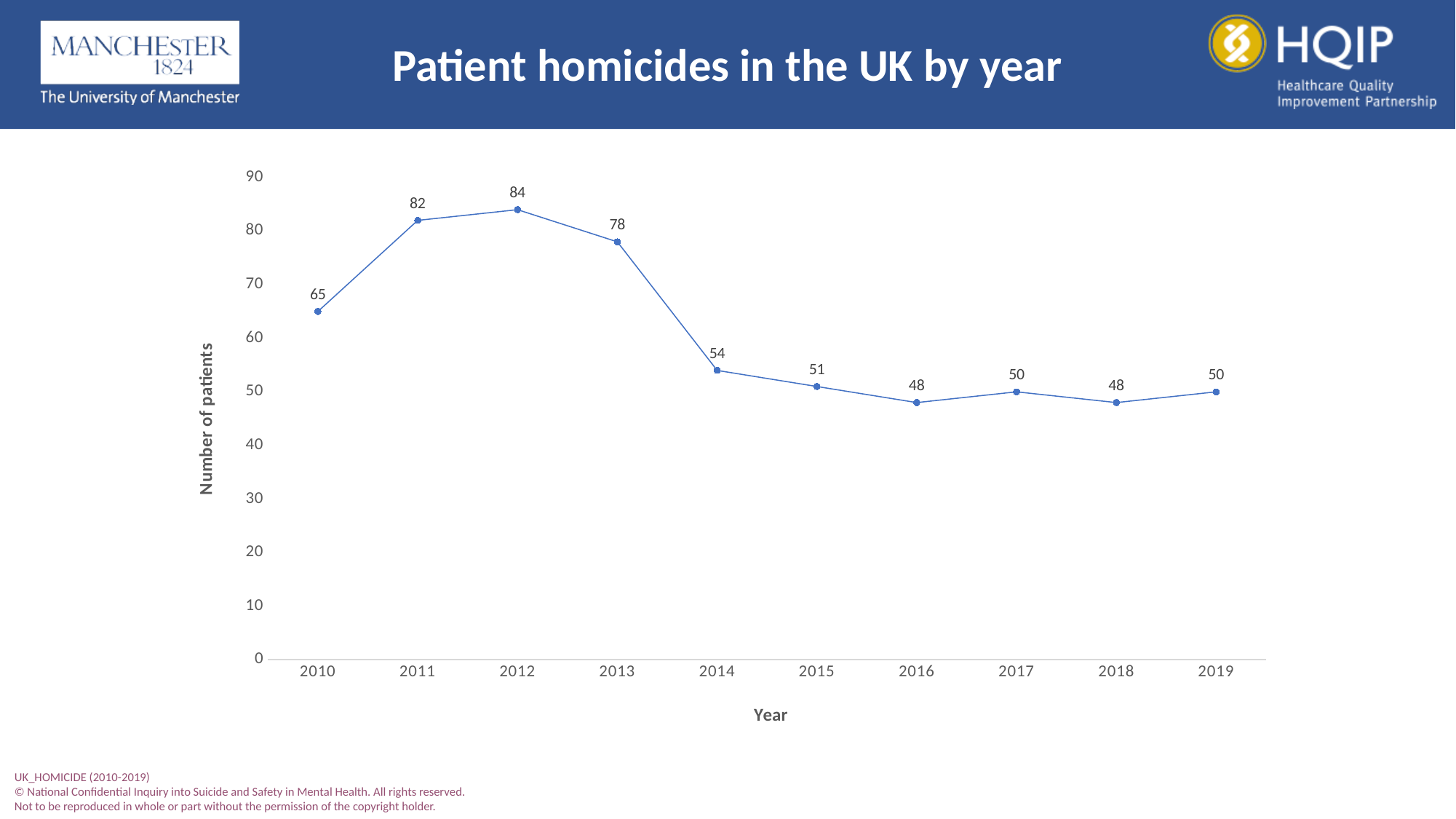
Which year has a higher number of patients, 2011 or 2015? 2011 What is the number of patients in 2010? 65 What is the difference in the number of patients between 2013 and 2014? 24 Does the number of patients rise or fall from 2012 to 2016? Fall What is the number of patients in 2012? 84 What is the title of the chart? Patient homicides in the UK by year What is the label of the vertical axis? Number of patients How many years are plotted on the chart? 10 Which year has the highest number of patients? 2012 Is the value for 2013 greater or less than 70? greater What kind of chart is shown on the slide? Line chart What is the number of patients in 2019? 50